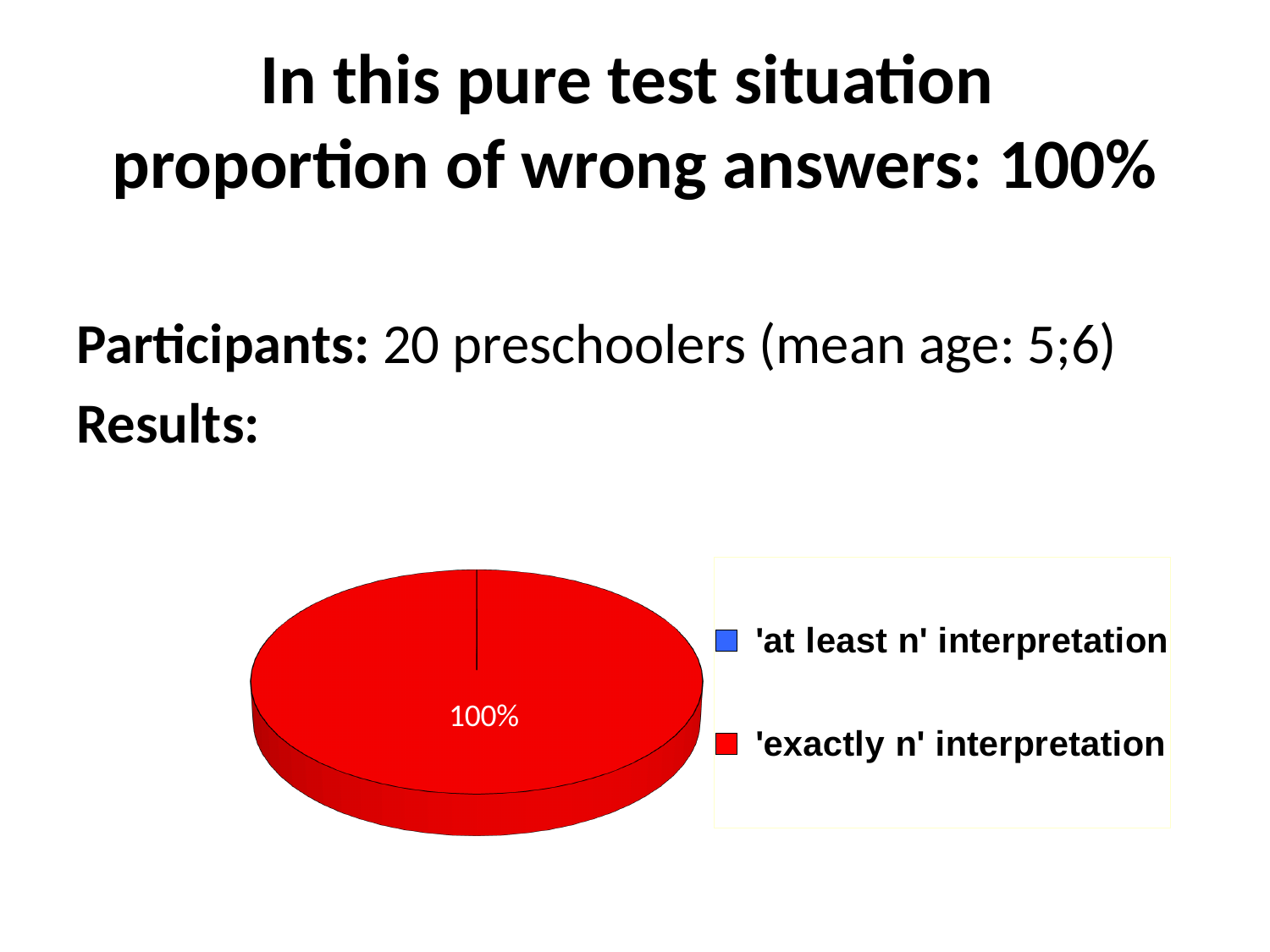
Which legend entry is shown in red? 'exactly n' interpretation Is the share for the 'exactly n' interpretation greater or less than 50%? greater What share of the pie does the 'exactly n' interpretation take? 100% What kind of chart is shown on the slide? pie chart How many entries does the legend list? 2 Which has the larger share of the pie, the 'at least n' interpretation or the 'exactly n' interpretation? 'exactly n' interpretation What is the data label printed on the pie chart? 100% Which legend entry is shown in blue? 'at least n' interpretation Which interpretation has the largest share of the pie? 'exactly n' interpretation